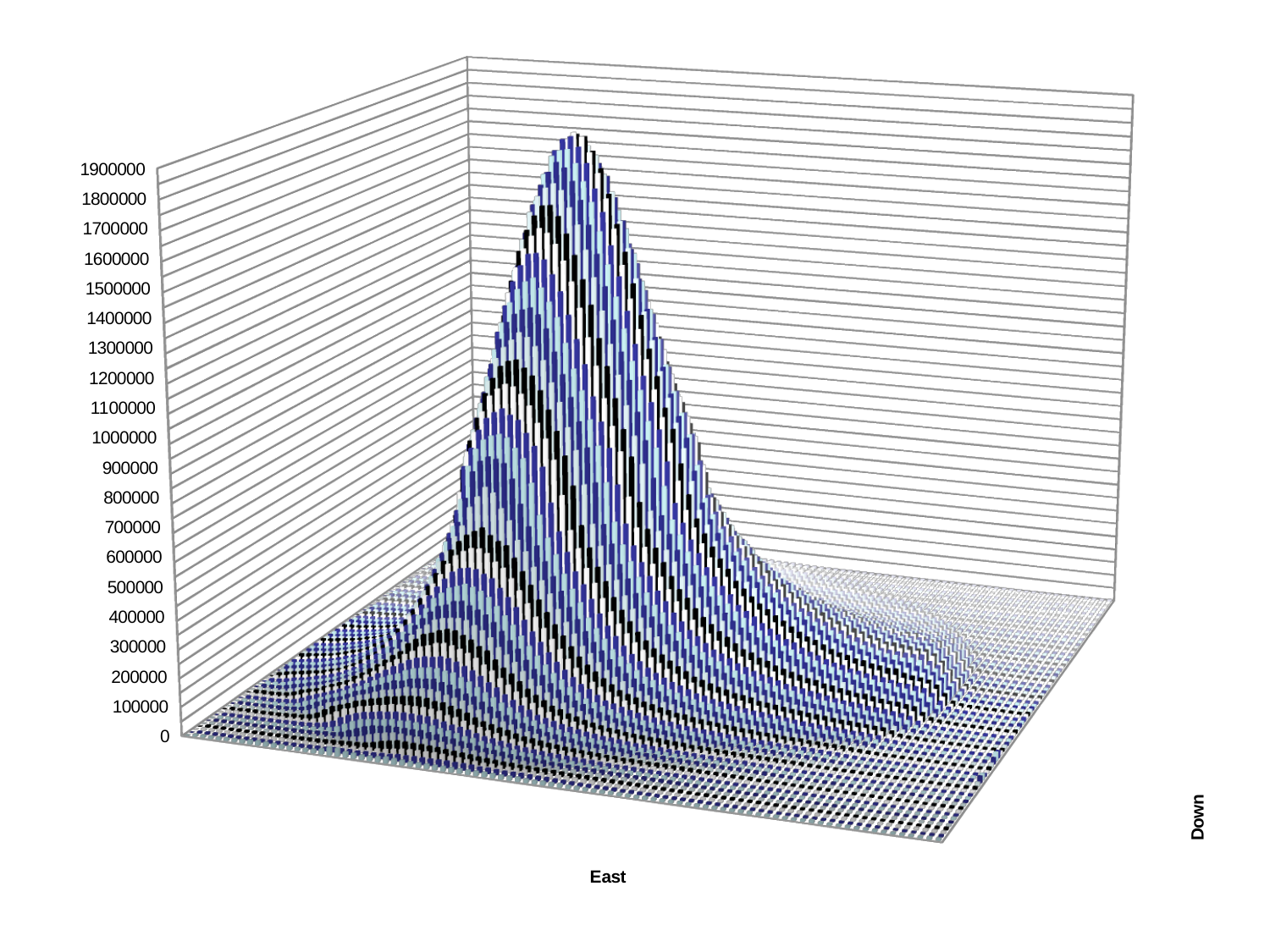
Is the value of the tallest bar in the chart greater or less than 500000? greater What kind of chart is shown on the slide? bar chart What is the label on the horizontal axis at the bottom of the chart? East What is the label on the depth axis at the right of the chart? Down Is the value of the tallest bar in the chart greater or less than 1000000? greater